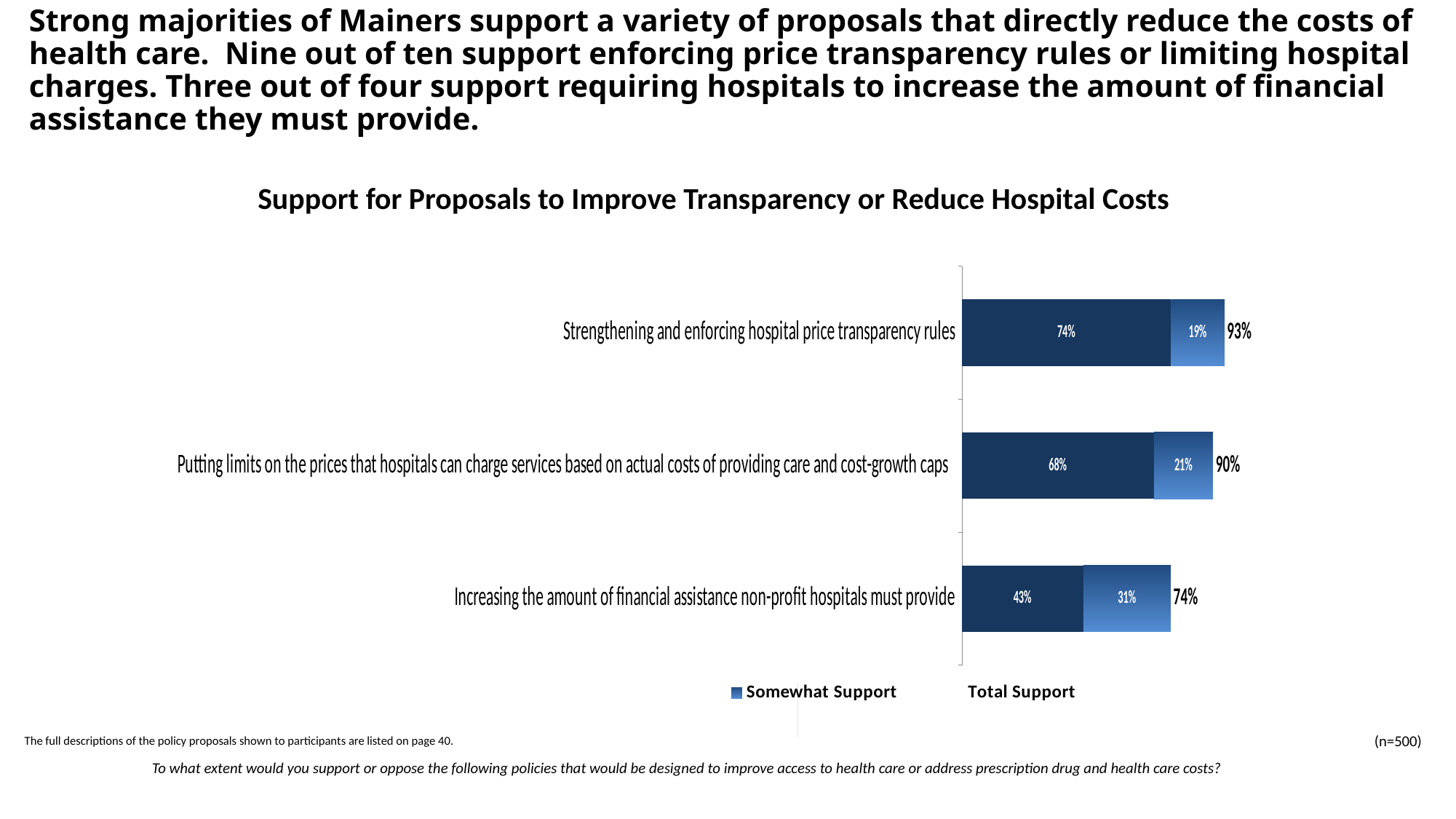
What is the total support value shown for 'Increasing the amount of financial assistance non-profit hospitals must provide'? 74% What kind of chart is shown on the slide? Bar chart What is the difference in total support between 'Strengthening and enforcing hospital price transparency rules' and 'Increasing the amount of financial assistance non-profit hospitals must provide'? 19 percentage points Which proposal has the lowest total support? Increasing the amount of financial assistance non-profit hospitals must provide What is the title of the chart? Support for Proposals to Improve Transparency or Reduce Hospital Costs Which has higher total support: 'Putting limits on the prices that hospitals can charge' or 'Increasing the amount of financial assistance non-profit hospitals must provide'? Putting limits on the prices that hospitals can charge What is the total support value shown for 'Putting limits on the prices that hospitals can charge services based on actual costs of providing care and cost-growth caps'? 90% What value is printed on the dark blue segment of the bar for 'Increasing the amount of financial assistance non-profit hospitals must provide'? 43% How many proposals (categories) are plotted in the chart? 3 Which proposal has the highest total support? Strengthening and enforcing hospital price transparency rules What value is printed on the lighter blue segment of the bar for 'Strengthening and enforcing hospital price transparency rules'? 19% What is the total support value shown for 'Strengthening and enforcing hospital price transparency rules'? 93%